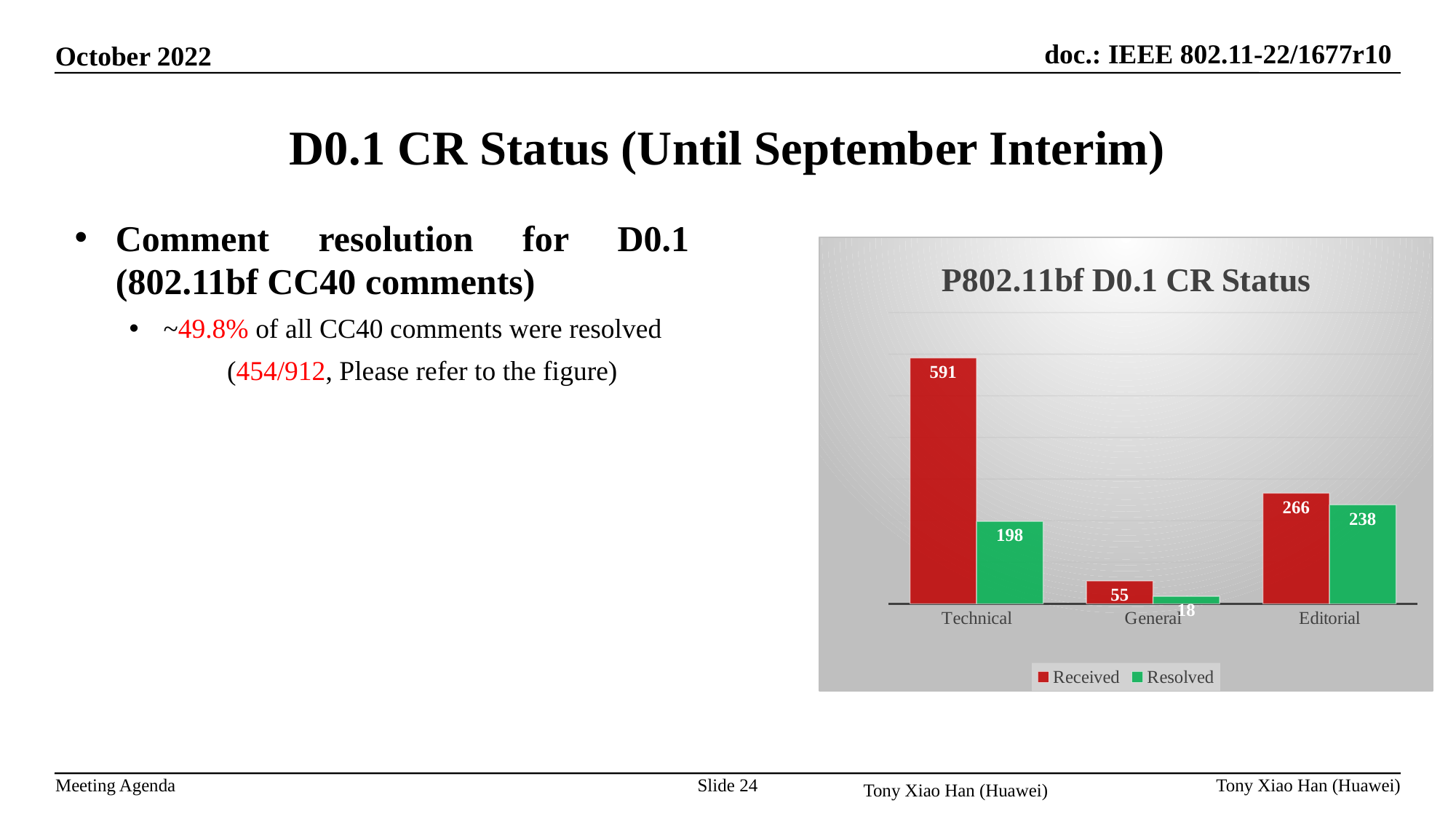
What is the Received value for Technical? 591 How many series does the legend list? 2 What is the difference between Received and Resolved for Editorial? 28 What is the Resolved value for General? 18 What is the Received value for Editorial? 266 What is the Resolved value for Editorial? 238 Which category has the lowest Resolved value? General What is the difference between Received and Resolved for Technical? 393 Which category has the highest Received value? Technical Which is larger, the Resolved value for Technical or the Resolved value for Editorial? Editorial What type of chart is shown? Bar chart How many categories are shown on the x axis? 3